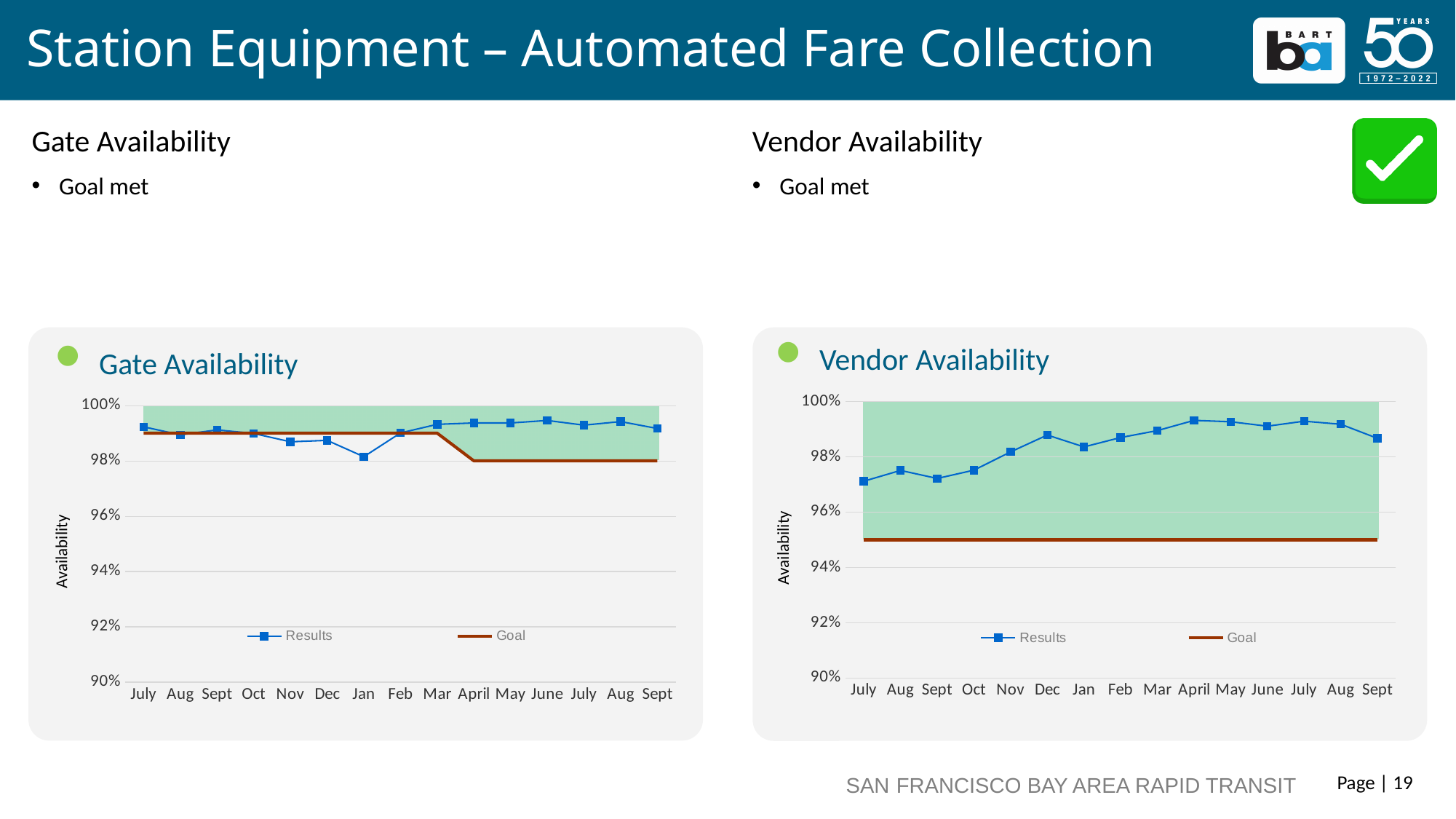
In the Gate Availability chart, what is the Goal value for May? 98% What kind of chart is the Gate Availability chart? line chart In the Vendor Availability chart, is the Results value for July (the first month) greater or less than 98%? less In the Vendor Availability chart, is the Results value for April greater or less than 98%? greater In the Gate Availability chart, is the Results value for Nov greater or less than 98%? greater How many series does the legend of the Gate Availability chart list? 2 In the Gate Availability chart, which month has the lowest Results value? Jan How many months are plotted on the x axis of the Vendor Availability chart? 15 In the Vendor Availability chart, do the Results values generally rise or fall from July to April? rise What are the two legend entries in the Vendor Availability chart? Results and Goal In the Vendor Availability chart, which is larger, the Results value for Nov or for the first July? Nov